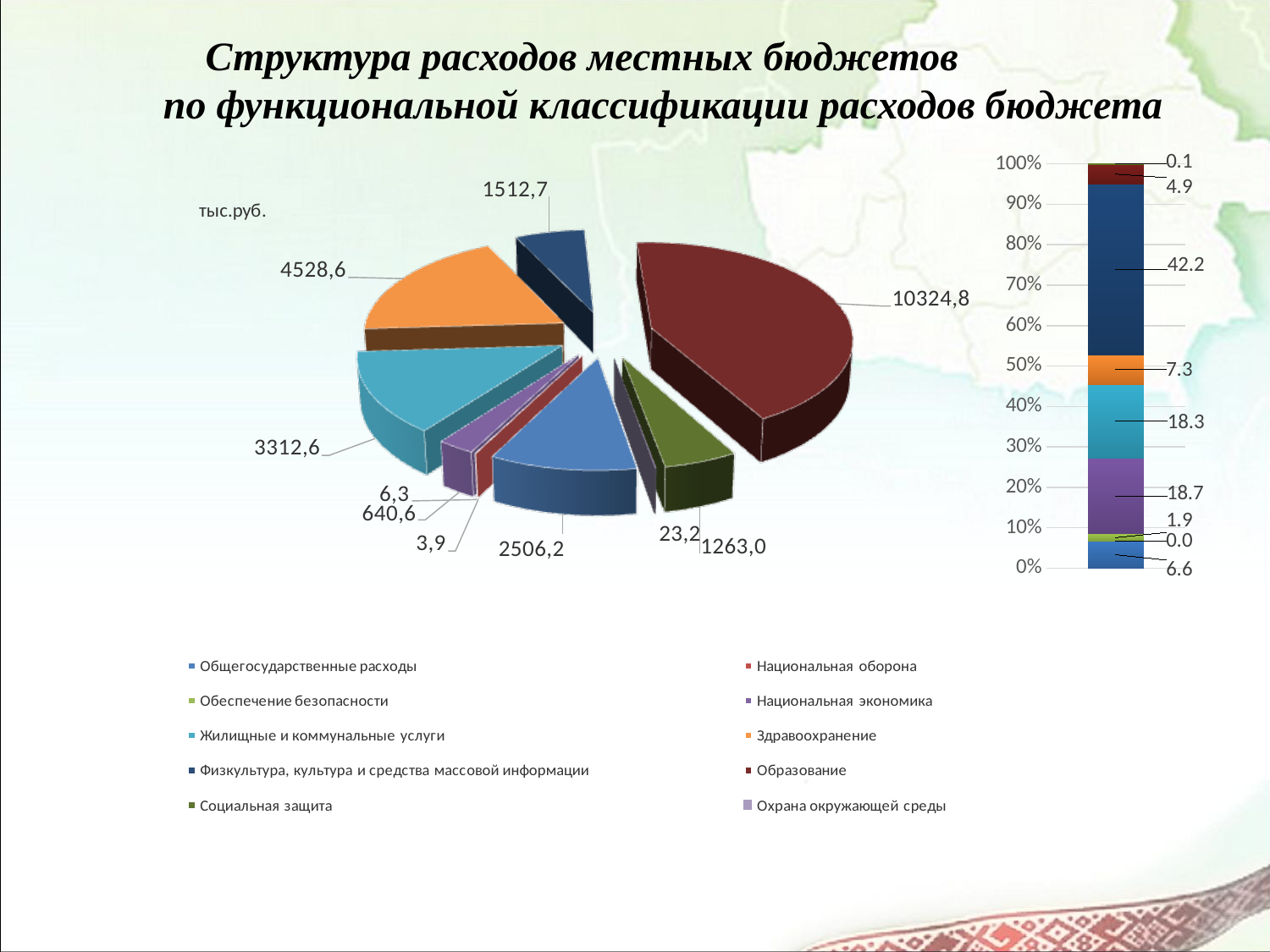
What type of chart is shown on the left of the slide? pie chart What unit is indicated next to the pie chart on the left? тыс.руб. In the pie chart on the left, what is the difference between the slices labelled 4528,6 and 3312,6? 1216,0 In the pie chart on the left, what is the value of the smallest slice? 3,9 In the pie chart on the left, which is larger: the orange slice labelled 4528,6 or the teal slice labelled 3312,6? 4528,6 In the stacked bar chart on the right, what is the value of the bottom segment? 6.6 In the pie chart on the left, what is the value of the largest slice? 10324,8 In the stacked bar chart on the right, what is the value of the largest segment? 42.2 How many entries does the legend list? 10 What type of chart is shown on the right of the slide? stacked bar chart In the stacked bar chart on the right, what is the value of the topmost segment? 0.1 How many slices does the pie chart on the left have? 10